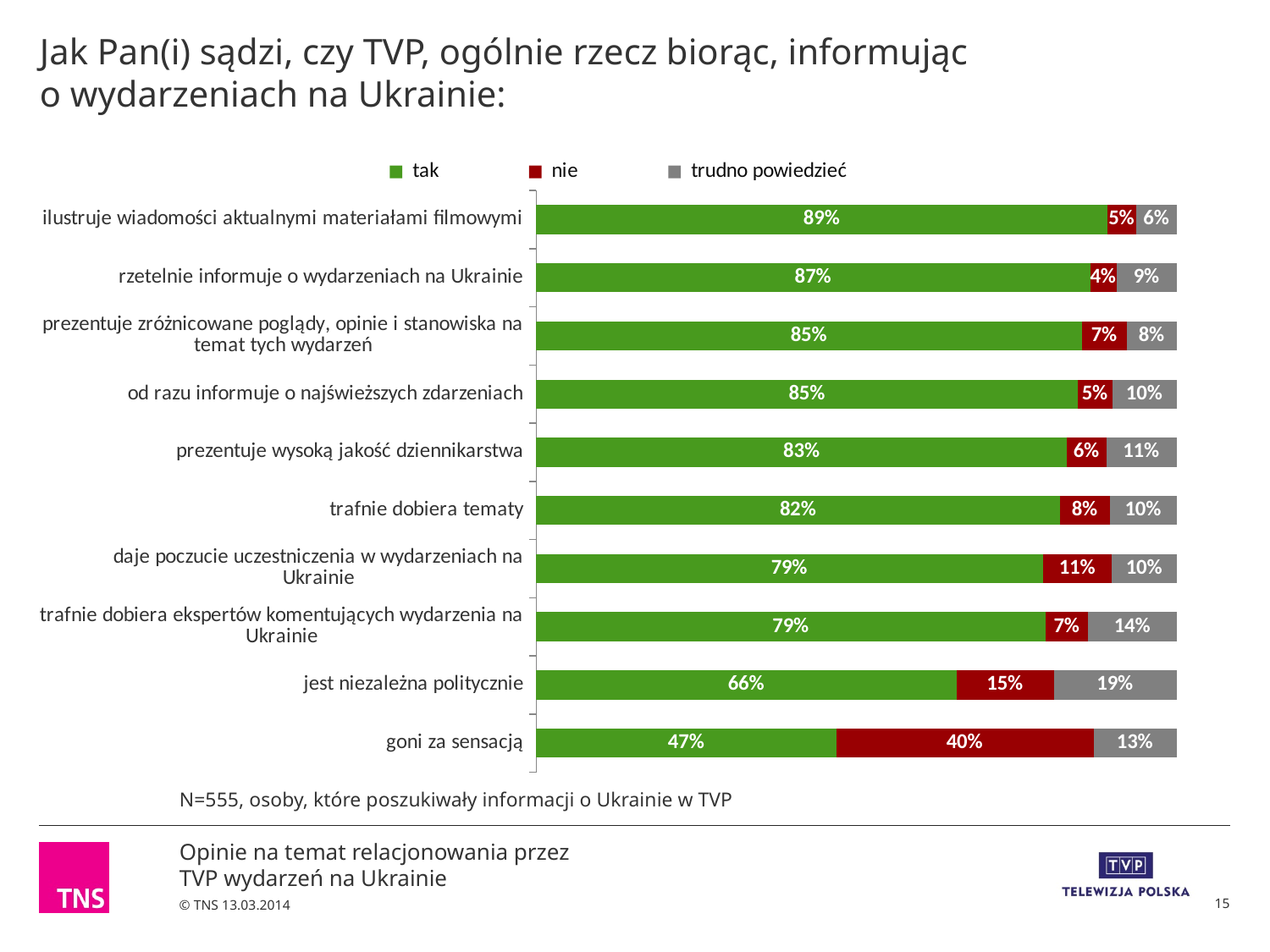
Which statement has the lowest "tak" percentage? goni za sensacją What kind of chart is shown on the slide? Stacked bar chart Which statement has the highest "tak" percentage? ilustruje wiadomości aktualnymi materiałami filmowymi What is the difference between the "tak" values for "rzetelnie informuje o wydarzeniach na Ukrainie" and "jest niezależna politycznie"? 21 percentage points What percentage answered "tak" for "goni za sensacją"? 47% Which is larger: the "nie" value for "daje poczucie uczestniczenia w wydarzeniach na Ukrainie" or for "trafnie dobiera tematy"? daje poczucie uczestniczenia w wydarzeniach na Ukrainie What is the sample size stated below the chart? N=555 What is the "trudno powiedzieć" value for "trafnie dobiera ekspertów komentujących wydarzenia na Ukrainie"? 14% Which statement has the highest "nie" percentage? goni za sensacją How many series does the legend list? 3 What percentage answered "nie" for "jest niezależna politycznie"? 15% How many statements (categories) are shown in the chart? 10